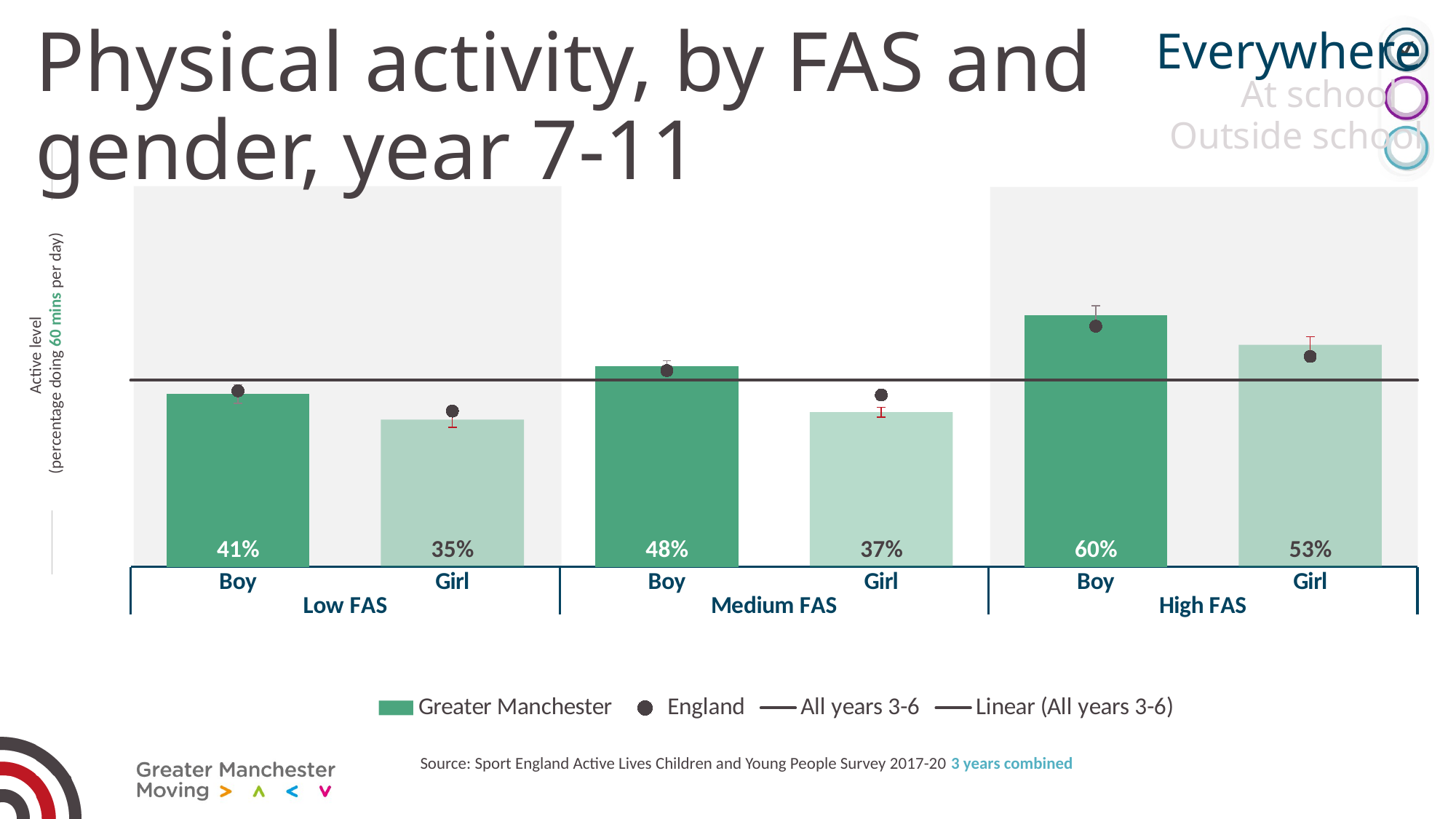
What is the Greater Manchester value for boys in the Low FAS group? 41% What is the Greater Manchester value for girls in the High FAS group? 53% How many entries does the legend list? 4 What is the Greater Manchester value for girls in the Medium FAS group? 37% What kind of chart is shown on the slide? Bar chart How many bars are plotted on the chart? 6 What is the difference between the boy and girl values in the High FAS group? 7% Which bar has the highest value on the chart? High FAS Boy Which is larger, the Medium FAS girl value or the Low FAS girl value? Medium FAS girl Which bar has the lowest value on the chart? Low FAS Girl Do the boy values rise or fall as FAS goes from Low to High? Rise What is the difference between the Medium FAS boy value and the Low FAS boy value? 7%